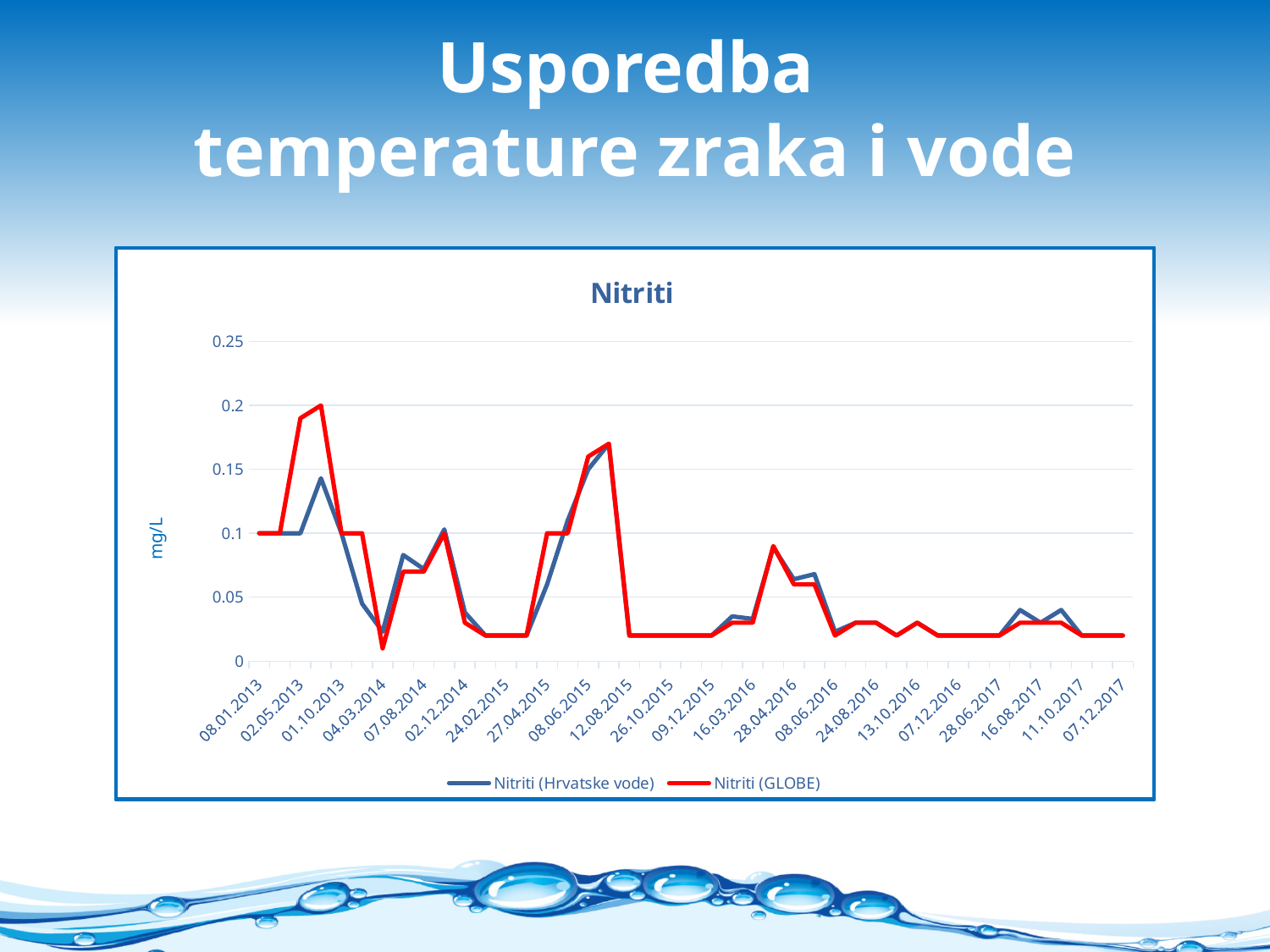
What is the title of the chart? Nitriti What type of chart is shown on the slide? line chart How many series does the legend list? 2 Are the nitrite values at the end of the period (2017) higher or lower than at the start (2013)? lower What is the highest value reached by the Nitriti (GLOBE) series? 0.2 What is the value of the Nitriti (GLOBE) series at 08.01.2013? 0.1 What unit is shown on the vertical axis label? mg/L Which series reaches the highest value on the chart? Nitriti (GLOBE) Is the value of the Nitriti (GLOBE) series at 26.10.2015 greater or less than 0.05? less Is the peak value of the Nitriti (Hrvatske vode) series in 2013 greater or less than 0.1? greater Is the peak of the Nitriti (GLOBE) series around 08.06.2015 greater or less than 0.15? greater